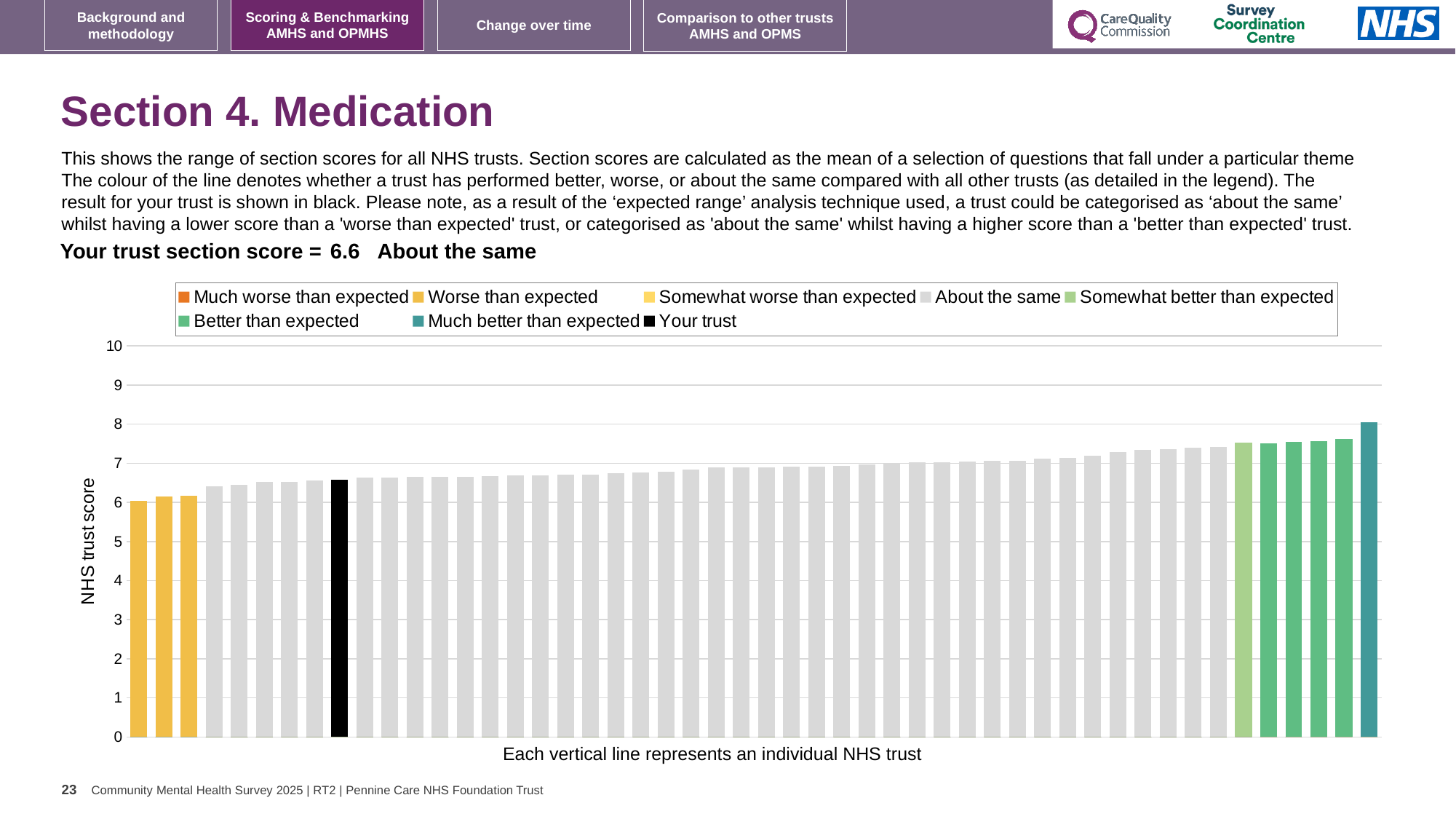
What is the label on the vertical axis of the chart? NHS trust score Which performance category is your trust placed in for Section 4. Medication? About the same Is the value of the shortest bar in the chart greater or less than 5? greater Is the value of the shortest bar in the chart greater or less than 7? less What kind of chart is shown on the slide? bar chart Is the value of the tallest bar in the chart greater or less than 7? greater Do the bar values rise or fall from left to right along the x axis? rise How many bars are coloured as 'Worse than expected'? 3 Which legend category does the tallest bar in the chart belong to? Much better than expected How many entries does the chart legend list? 8 What is the section score for your trust shown on the slide? 6.6